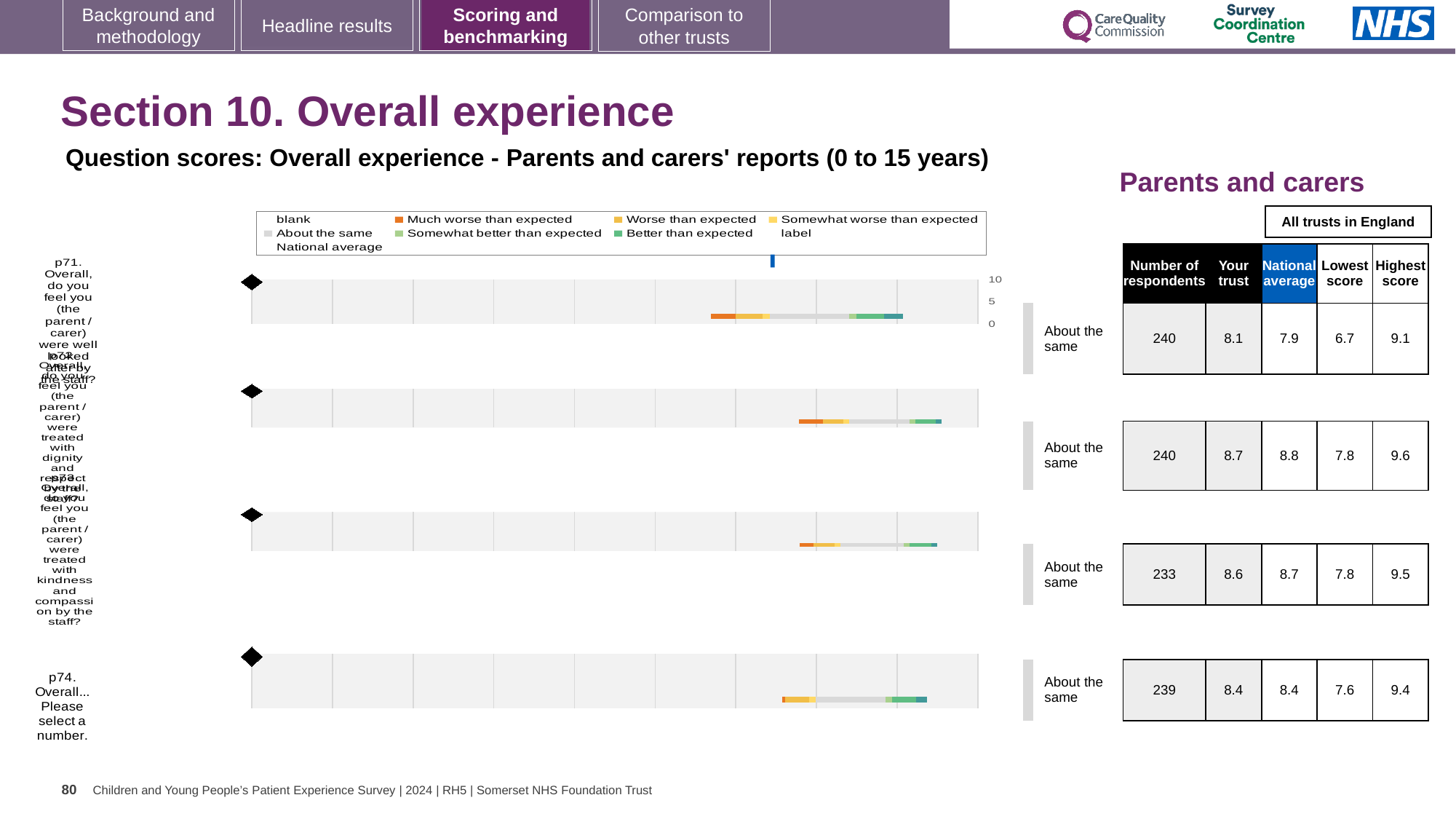
What is the national average score for question p71? 7.9 What is the 'Your trust' score for question p71? 8.1 Which row of the table has the highest 'Your trust' score? the second row (8.7) How many question rows (bars) are plotted in the chart? 4 For question p71, which is larger: the 'Your trust' score or the national average? Your trust For question p71, what is the difference between the highest score and the lowest score? 2.4 What kind of chart is used to show the question scores on this slide? bar chart What benchmark category is shown for question p74 (Overall... Please select a number)? About the same What is the highest score for question p74 (Overall... Please select a number)? 9.4 Which row of the table has the lowest number of respondents? the third row (233) What is the national average for question p74 (Overall... Please select a number)? 8.4 In the table next to the chart, what is the number of respondents for question p71? 240